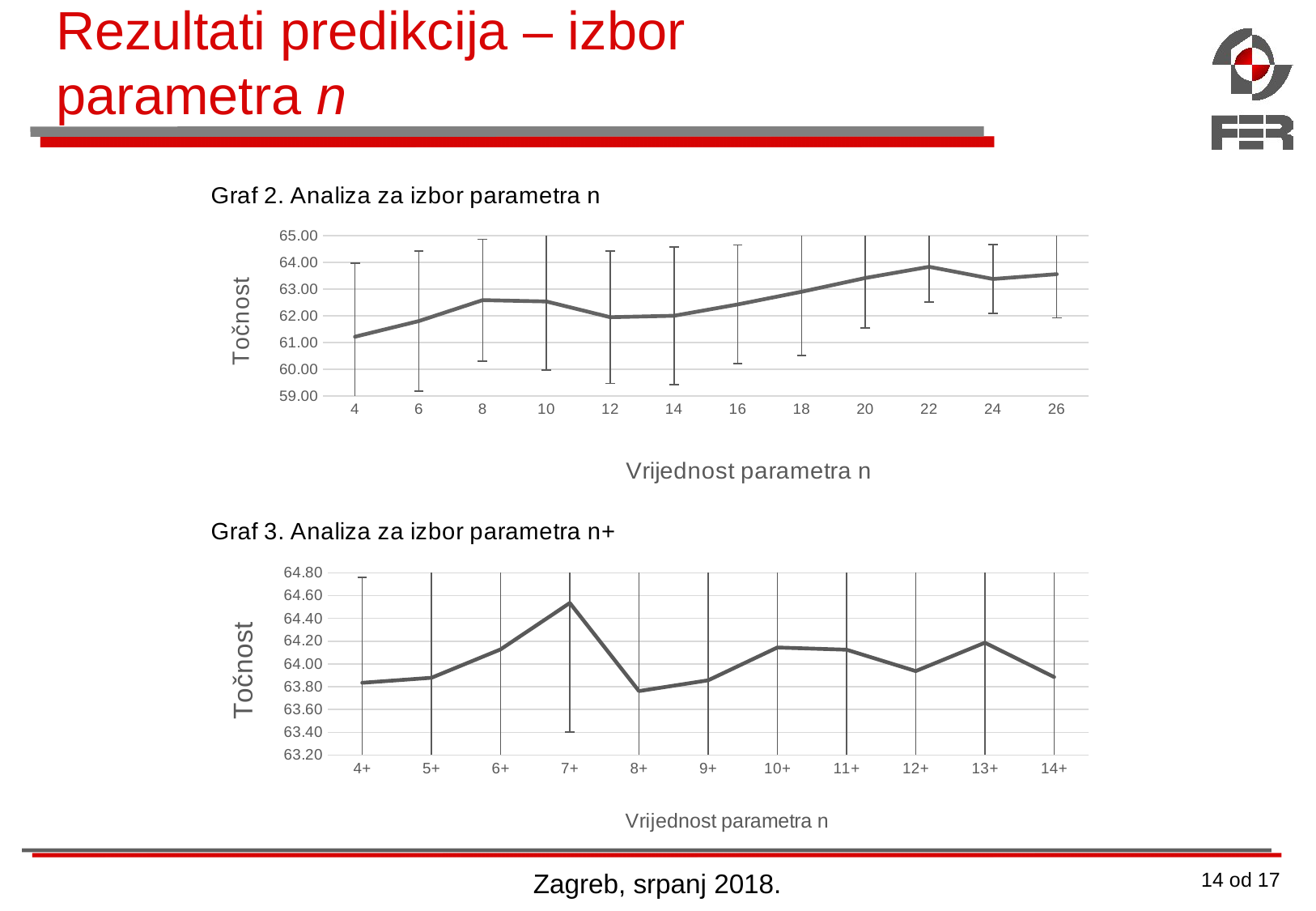
In Graf 2 (Analiza za izbor parametra n), at which value of parameter n is the accuracy highest? 22 In Graf 2 (Analiza za izbor parametra n), at which value of parameter n is the accuracy lowest? 4 In Graf 2 (Analiza za izbor parametra n), is the value for n = 22 greater or less than 63.00? greater How many data points are plotted in Graf 2 (Analiza za izbor parametra n)? 12 In Graf 2 (Analiza za izbor parametra n), does the accuracy generally rise or fall as n increases from 4 to 26? rise How many data points are plotted in Graf 3 (Analiza za izbor parametra n+)? 11 In Graf 2 (Analiza za izbor parametra n), is the value for n = 4 greater or less than 62.00? less What is the label of the vertical axis in Graf 3 (Analiza za izbor parametra n+)? Točnost What kind of chart is Graf 2 (Analiza za izbor parametra n)? line chart In Graf 3 (Analiza za izbor parametra n+), at which value of parameter n is the accuracy highest? 7+ In Graf 3 (Analiza za izbor parametra n+), is the value for 7+ greater or less than 64.40? greater What kind of chart is Graf 3 (Analiza za izbor parametra n+)? line chart